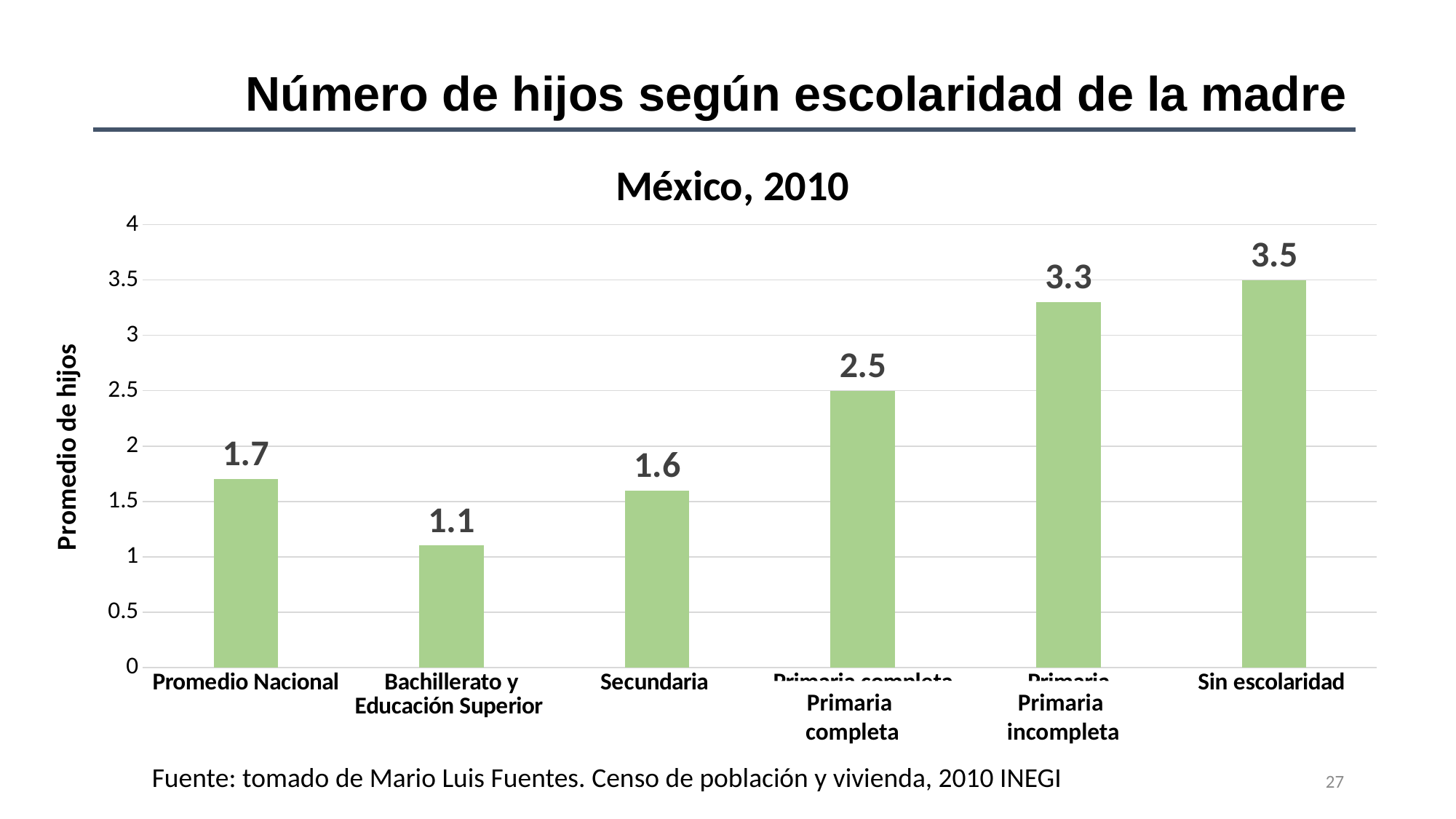
How many categories are shown on the x axis? 6 Which is larger, the value for Primaria completa or the value for Secundaria? Primaria completa What is the value for Bachillerato y Educación Superior? 1.1 What type of chart is shown on the slide? Bar chart What is the average number of children for mothers with Secundaria? 1.6 Which category has the lowest average number of children? Bachillerato y Educación Superior What is the value for Sin escolaridad? 3.5 What is the difference between the values for Sin escolaridad and Bachillerato y Educación Superior? 2.4 Which category has the highest average number of children? Sin escolaridad What is the difference between Primaria incompleta and Primaria completa? 0.8 What is the label of the y axis? Promedio de hijos What is the value for Promedio Nacional? 1.7